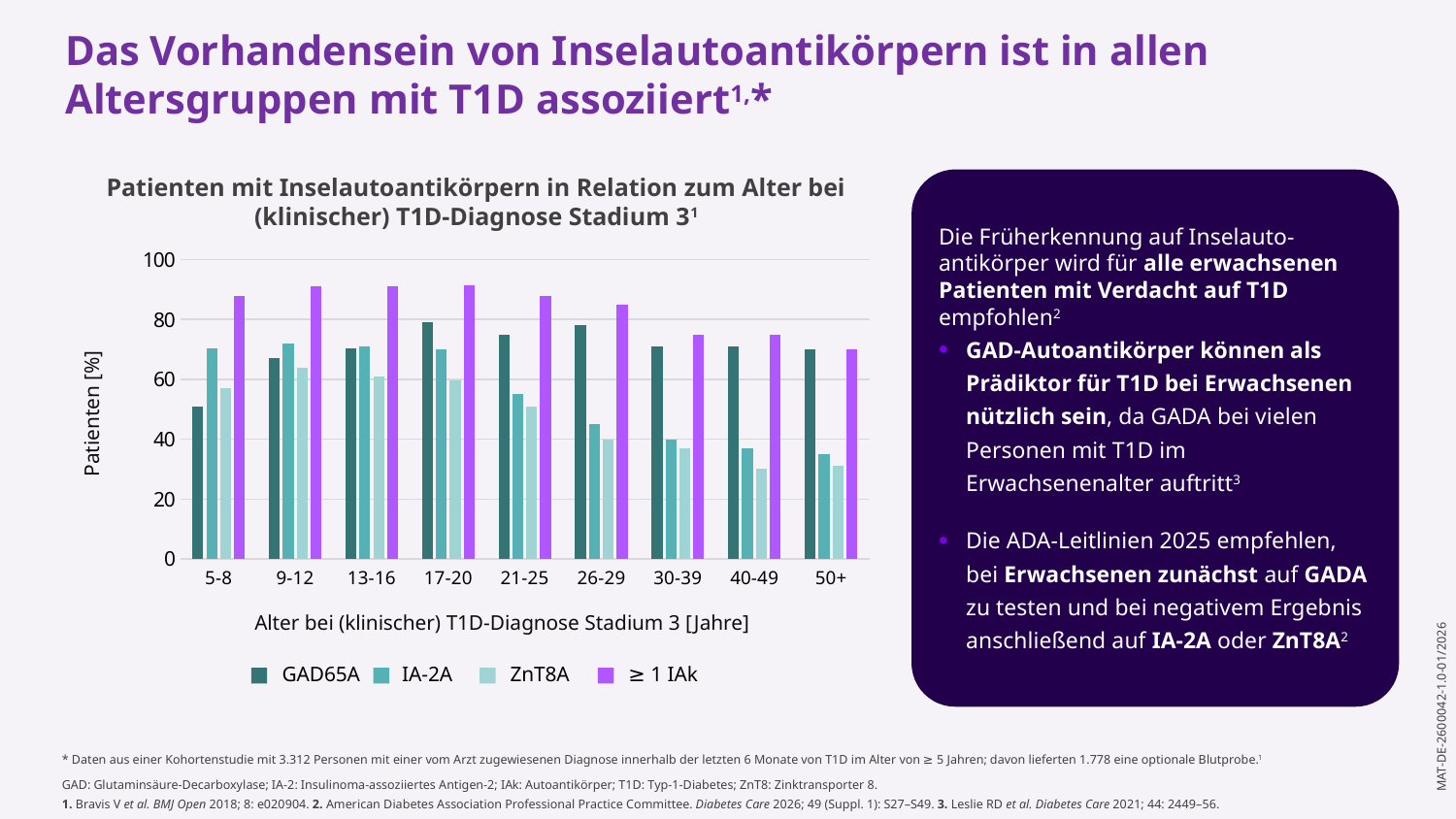
Is the ZnT8A value for the 50+ age group greater or less than 40? less In the 50+ age group, which is larger: the GAD65A value or the IA-2A value? GAD65A What is the label of the y axis of the chart? Patienten [%] Is the GAD65A value for the 5-8 age group greater or less than 60? less Is the ≥ 1 IAk value for the 17-20 age group greater or less than 80? greater How many series does the chart legend list? 4 Which age group has the lowest GAD65A value? 5-8 In the 5-8 age group, which is larger: the GAD65A value or the IA-2A value? IA-2A How many age groups are shown on the x axis of the chart? 9 What kind of chart is shown on the slide? bar chart Do the ZnT8A values generally rise or fall as the age groups increase along the x axis? fall